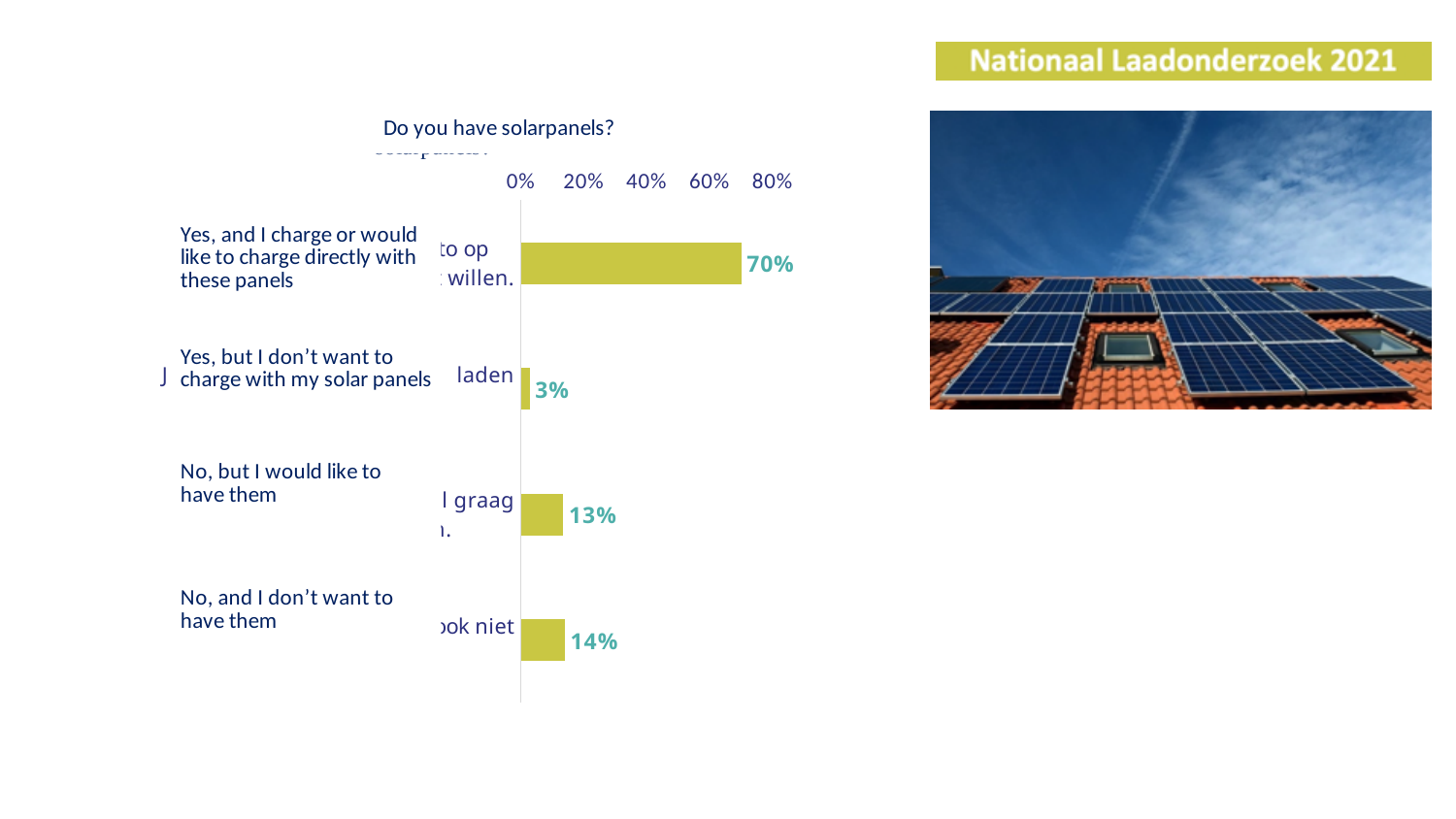
Which is larger: the share for "No, but I would like to have them" or for "Yes, but I don't want to charge with my solar panels"? No, but I would like to have them What is the difference in percentage points between "Yes, and I charge or would like to charge directly with these panels" and "No, and I don't want to have them"? 56 What percentage of respondents answered "No, but I would like to have them"? 13% What is the title of the chart? Do you have solarpanels? Is the value for "Yes, and I charge or would like to charge directly with these panels" greater or less than 60%? greater Which answer category has the highest percentage? Yes, and I charge or would like to charge directly with these panels What percentage of respondents answered "Yes, and I charge or would like to charge directly with these panels"? 70% How many answer categories are shown in the chart? 4 What percentage of respondents answered "Yes, but I don't want to charge with my solar panels"? 3% What type of chart is shown on the slide? Bar chart Which answer category has the lowest percentage? Yes, but I don't want to charge with my solar panels What percentage of respondents answered "No, and I don't want to have them"? 14%